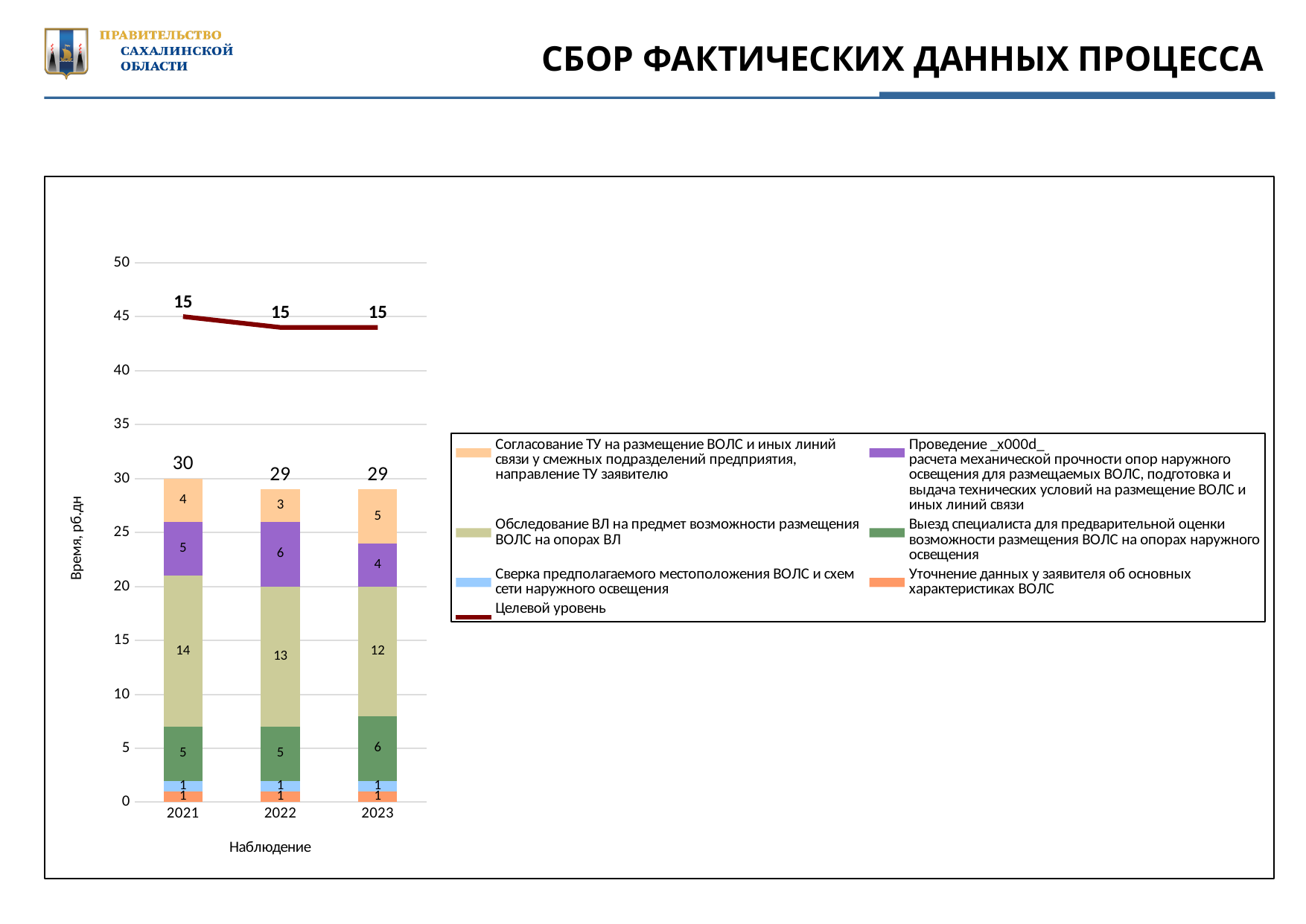
What is the value of the 'Согласование ТУ на размещение ВОЛС и иных линий связи у смежных подразделений предприятия, направление ТУ заявителю' segment in 2023? 5 How many years (categories) are shown on the x axis? 3 What is the label of the y axis? Время, рб.дн Which year has the highest stacked bar total? 2021 What is the labelled value of the 'Целевой уровень' line in 2022? 15 Which is larger: the purple 'Проведение расчета' segment in 2022 or in 2023? 2022 What is the value of the 'Обследование ВЛ на предмет возможности размещения ВОЛС на опорах ВЛ' segment in 2022? 13 What is the total of the stacked bar for 2021? 30 How many entries does the legend list? 7 What is the difference between the 'Обследование ВЛ на предмет возможности размещения ВОЛС на опорах ВЛ' segment in 2021 and in 2023? 2 What is the value of the 'Выезд специалиста для предварительной оценки возможности размещения ВОЛС на опорах наружного освещения' segment in 2023? 6 What is the total of the stacked bar for 2023? 29